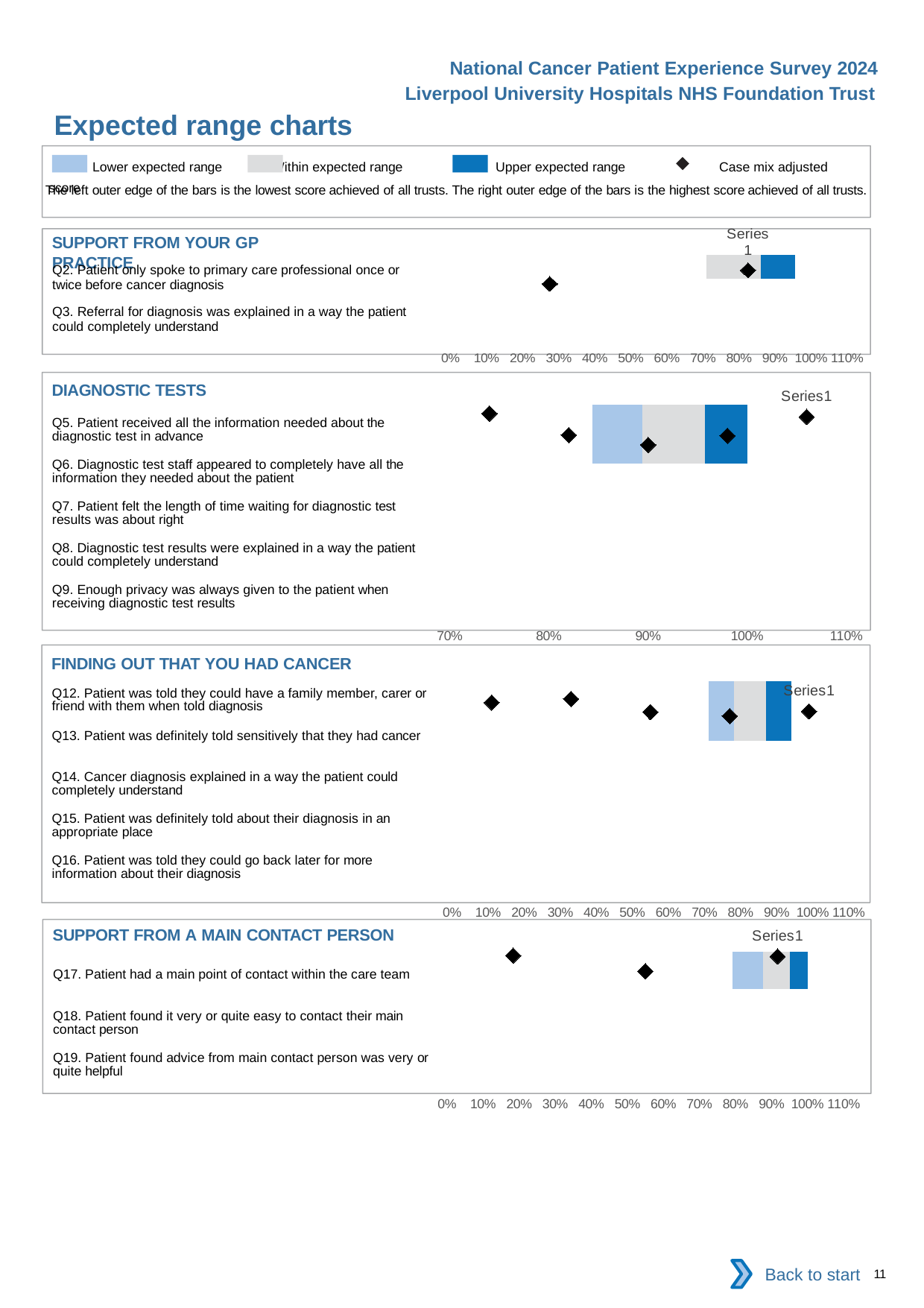
In the 'SUPPORT FROM A MAIN CONTACT PERSON' chart, is the leftmost diamond marker greater or less than 30%? less In the legend at the top of the slide, what does the diamond marker represent? Case mix adjusted score What is the lowest axis tick shown on the 'DIAGNOSTIC TESTS' chart? 70% How many questions are listed in the 'SUPPORT FROM A MAIN CONTACT PERSON' chart? 3 What kind of chart is used in the 'DIAGNOSTIC TESTS' section? bar chart In the 'DIAGNOSTIC TESTS' chart, is the leftmost diamond marker greater or less than 80%? less In the 'FINDING OUT THAT YOU HAD CANCER' chart, is the leftmost diamond marker greater or less than 20%? less How many entries does the legend at the top of the slide list? 4 How many questions are listed in the 'FINDING OUT THAT YOU HAD CANCER' chart? 5 How many questions are listed in the 'SUPPORT FROM YOUR GP PRACTICE' chart? 2